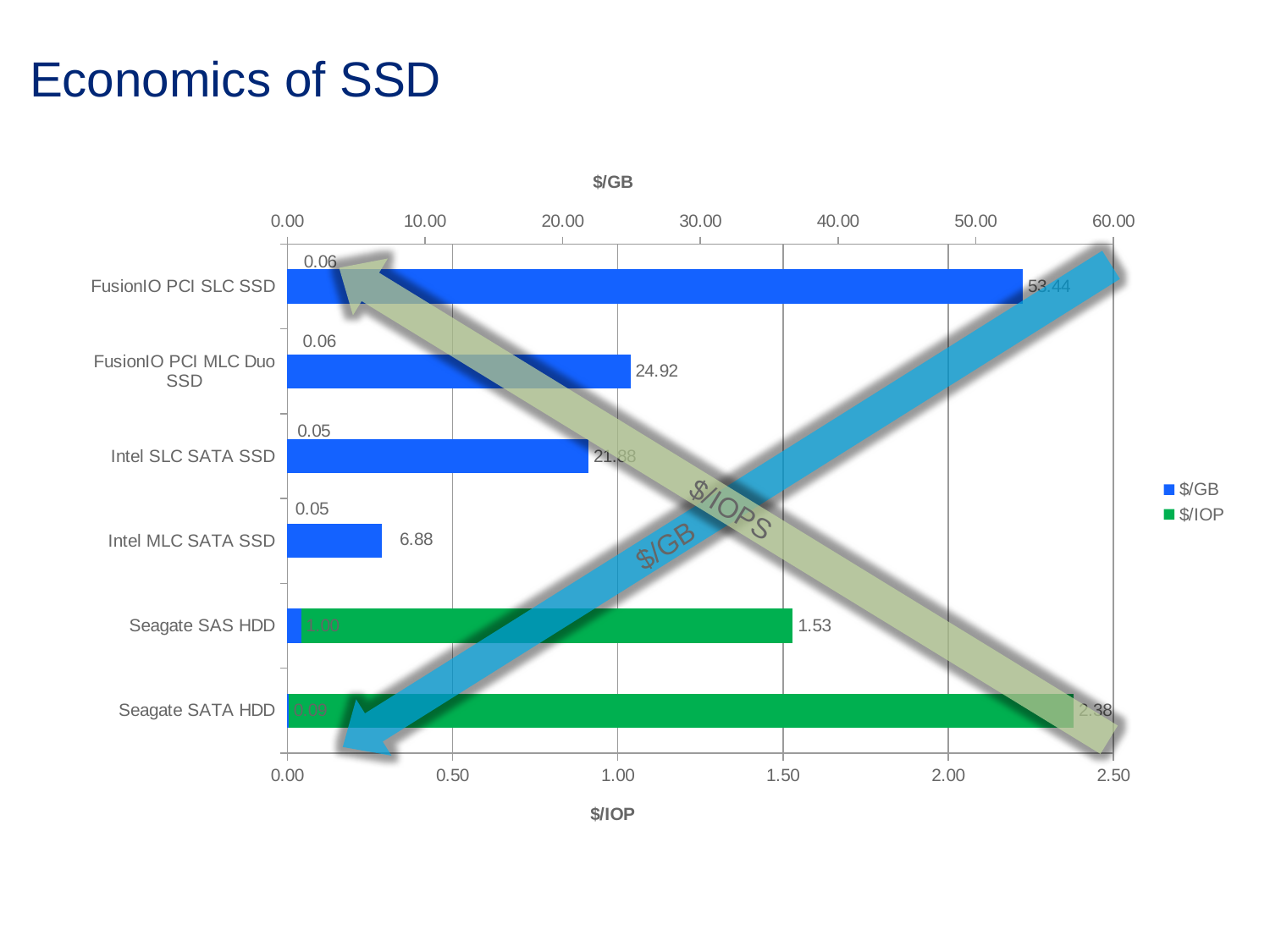
What kind of chart is shown on the slide? bar chart What is the $/IOP value for FusionIO PCI SLC SSD? 0.06 How many series does the legend list? 2 What is the difference in $/GB between FusionIO PCI MLC Duo SSD and Intel MLC SATA SSD? 18.04 What is the $/GB value for FusionIO PCI MLC Duo SSD? 24.92 Is the $/GB value for FusionIO PCI SLC SSD greater or less than 50.00? greater What is the $/IOP value for Seagate SAS HDD? 1.53 Which device has the highest $/GB value? FusionIO PCI SLC SSD Which device has the highest $/IOP value? Seagate SATA HDD What is the $/GB value for Intel MLC SATA SSD? 6.88 What are the two series names shown in the legend? $/GB and $/IOP How many storage devices (categories) are plotted on the chart? 6